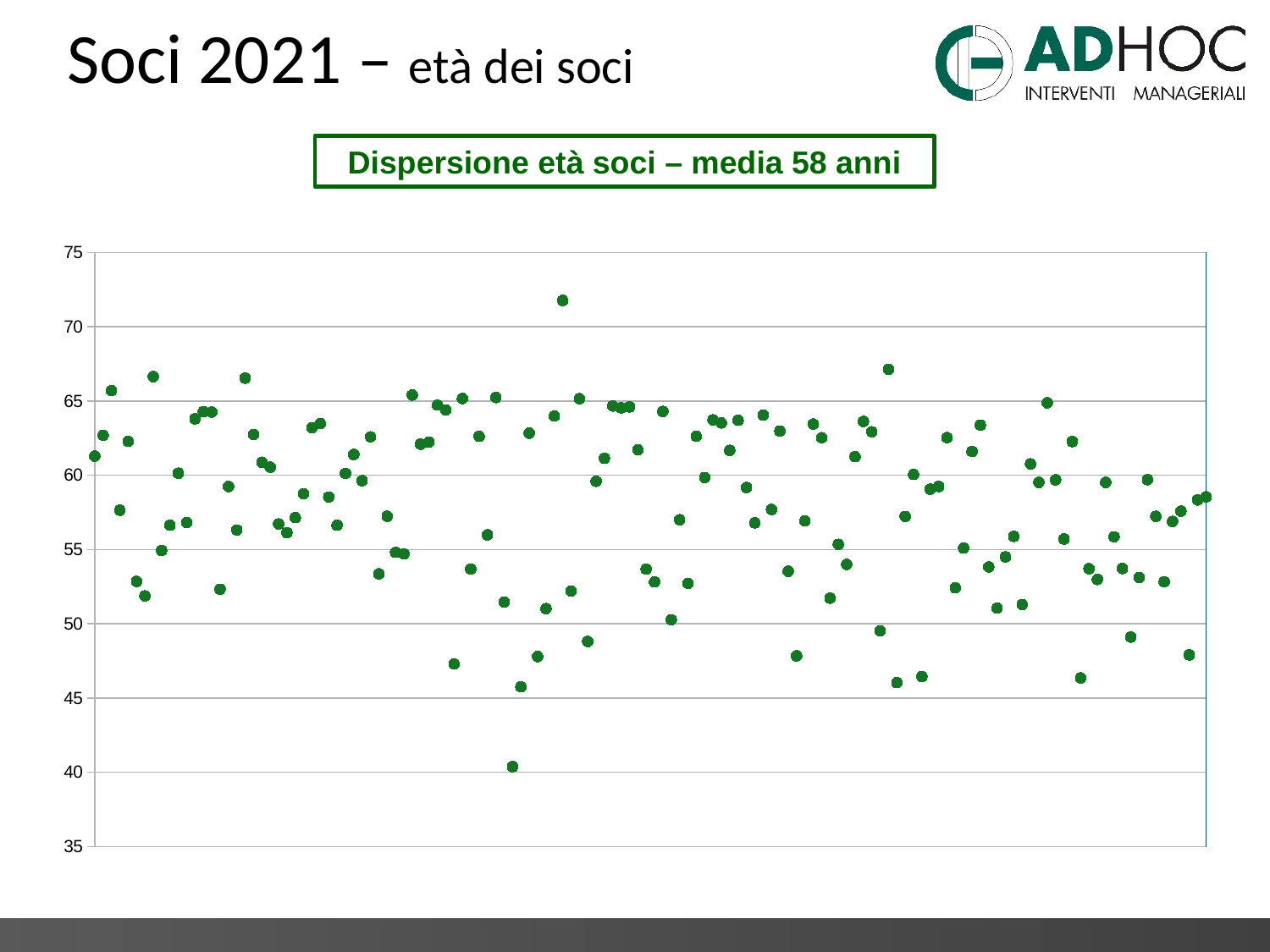
Is the lowest point on the chart greater or less than 35? greater Is the highest point on the chart greater or less than 75? less What is the title of the chart on the slide? Dispersione età soci – media 58 anni What is the minimum value shown on the vertical axis? 35 Is the highest point on the chart greater or less than 70? greater What kind of chart is shown on the slide? Scatter chart According to the chart title, what is the average age of the members (soci)? 58 anni